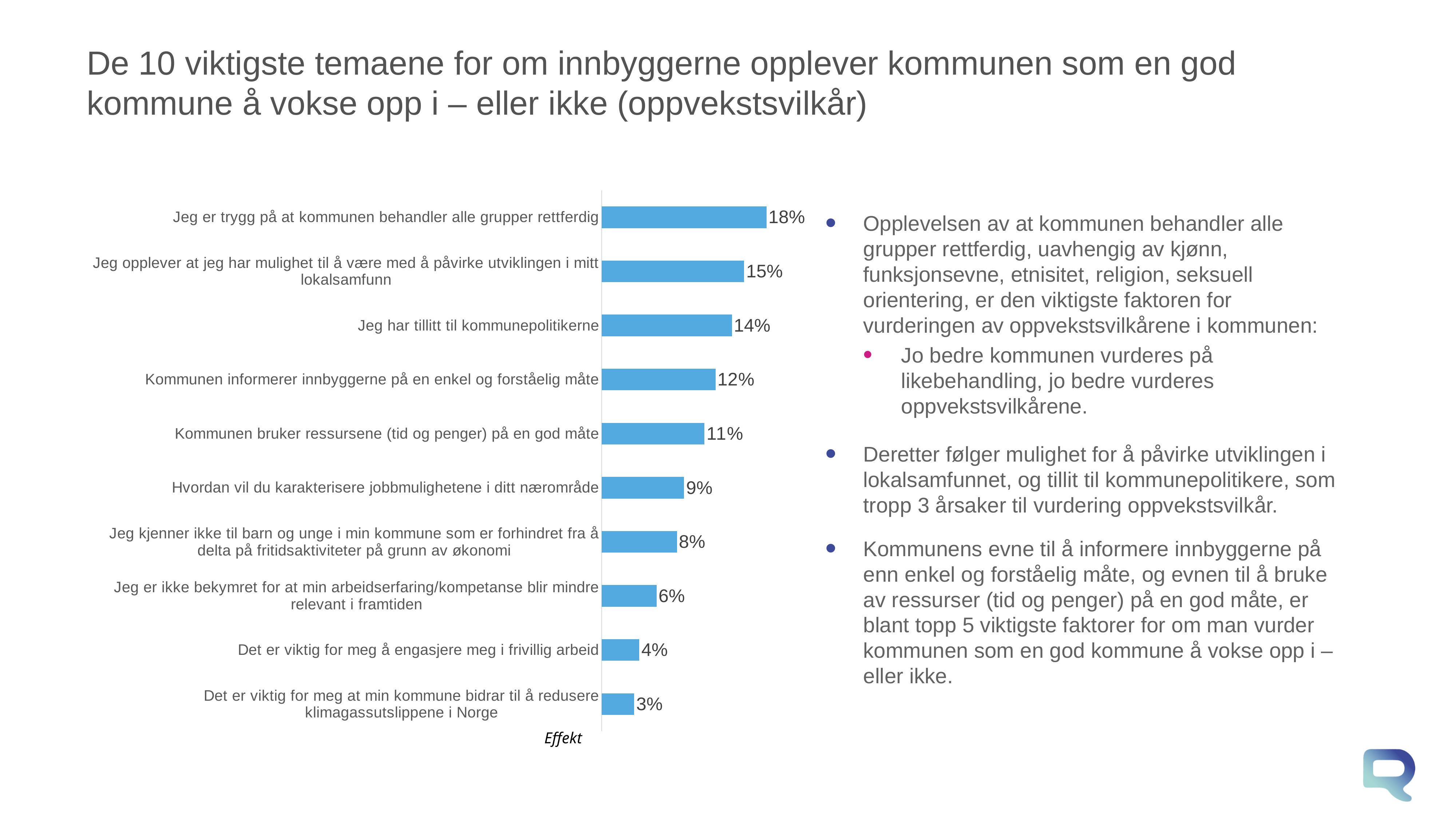
What is the value for "Jeg er trygg på at kommunen behandler alle grupper rettferdig"? 18% How many categories are shown in the chart? 10 What is the value for "Jeg har tillitt til kommunepolitikerne"? 14% Which category has the lowest value? Det er viktig for meg at min kommune bidrar til å redusere klimagassutslippene i Norge What label appears below the chart's axis? Effekt What is the difference between the highest and lowest values in the chart? 15% What kind of chart is shown on the slide? Bar chart What is the difference between the values for "Jeg opplever at jeg har mulighet til å være med å påvirke utviklingen i mitt lokalsamfunn" and "Kommunen informerer innbyggerne på en enkel og forståelig måte"? 3% What is the value for "Det er viktig for meg å engasjere meg i frivillig arbeid"? 4% What is the value for "Kommunen bruker ressursene (tid og penger) på en god måte"? 11% Which category has the highest value? Jeg er trygg på at kommunen behandler alle grupper rettferdig Which is larger: the value for "Hvordan vil du karakterisere jobbmulighetene i ditt nærområde" or the value for "Jeg kjenner ikke til barn og unge i min kommune som er forhindret fra å delta på fritidsaktiviteter på grunn av økonomi"? Hvordan vil du karakterisere jobbmulighetene i ditt nærområde